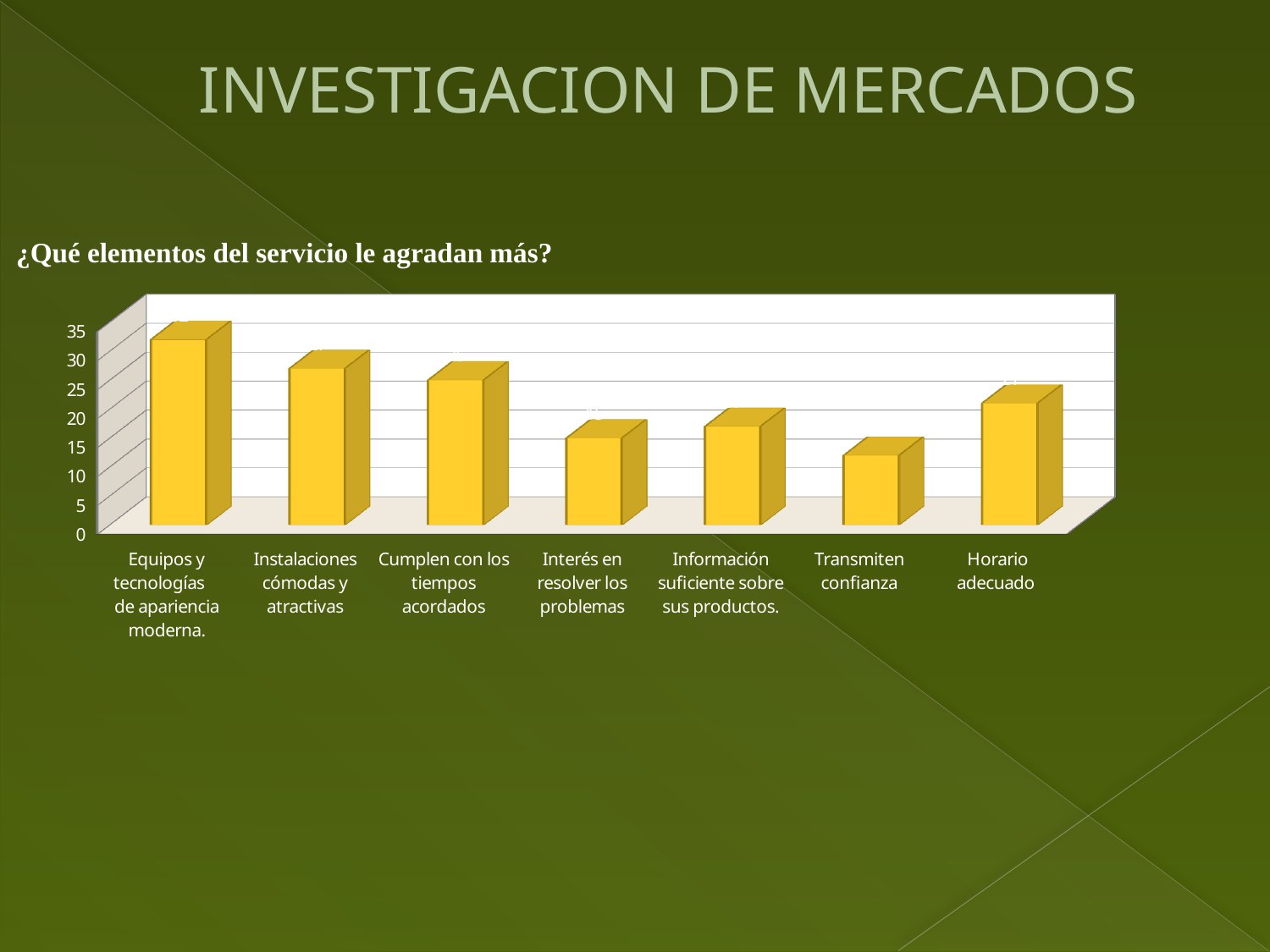
Is the value for Interés en resolver los problemas greater or less than 20? less Is the value for Transmiten confianza greater or less than 15? less What kind of chart is shown on the slide? Bar chart What question is written as the heading above the chart? ¿Qué elementos del servicio le agradan más? Which is larger, the value for Información suficiente sobre sus productos or the value for Transmiten confianza? Información suficiente sobre sus productos. Which category has the lowest bar in the chart? Transmiten confianza Which category has the highest bar in the chart? Equipos y tecnologías de apariencia moderna. Which is larger, the value for Horario adecuado or the value for Interés en resolver los problemas? Horario adecuado Is the value for Equipos y tecnologías de apariencia moderna greater or less than 30? greater How many categories are shown on the x axis of the chart? 7